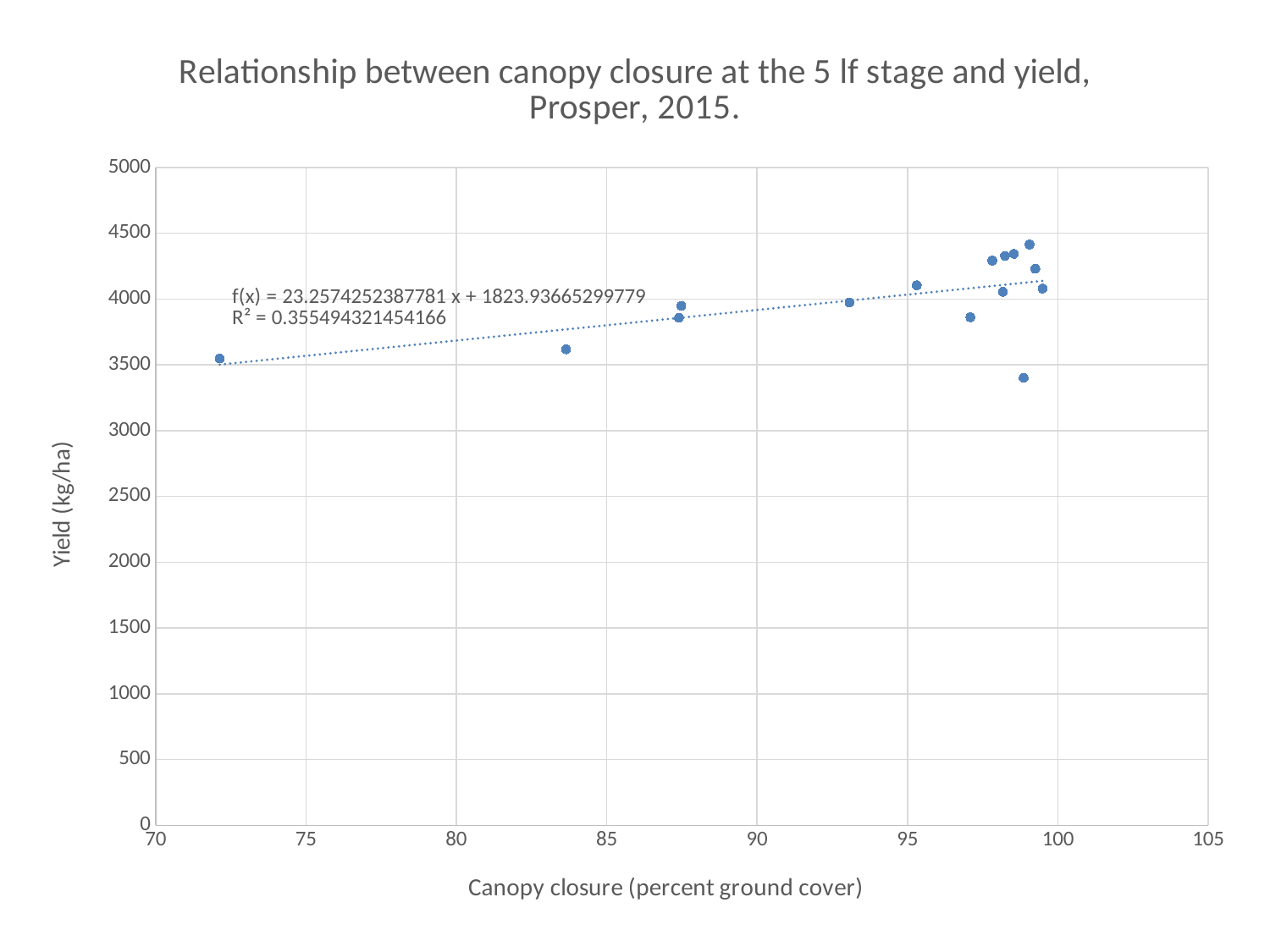
What kind of chart is shown on the slide? scatter chart Is the yield of the lowest point on the chart greater or less than 3500 kg/ha? less What is the label of the y axis? Yield (kg/ha) What is the maximum value shown on the y axis? 5000 What R² value is printed on the chart? 0.355494321454166 According to the trendline, does yield rise or fall as canopy closure increases? rise Is the yield of the point with the lowest canopy closure (around 72 percent) greater or less than 4000 kg/ha? less What is the title of the chart? Relationship between canopy closure at the 5 lf stage and yield, Prosper, 2015. Which has the higher yield: the point at about 72 percent canopy closure or the point at about 95 percent canopy closure? the point at about 95 percent canopy closure What is the slope of the fitted line printed on the chart? 23.2574252387781 Is the yield of the point at about 93 percent canopy closure greater or less than 3500 kg/ha? greater